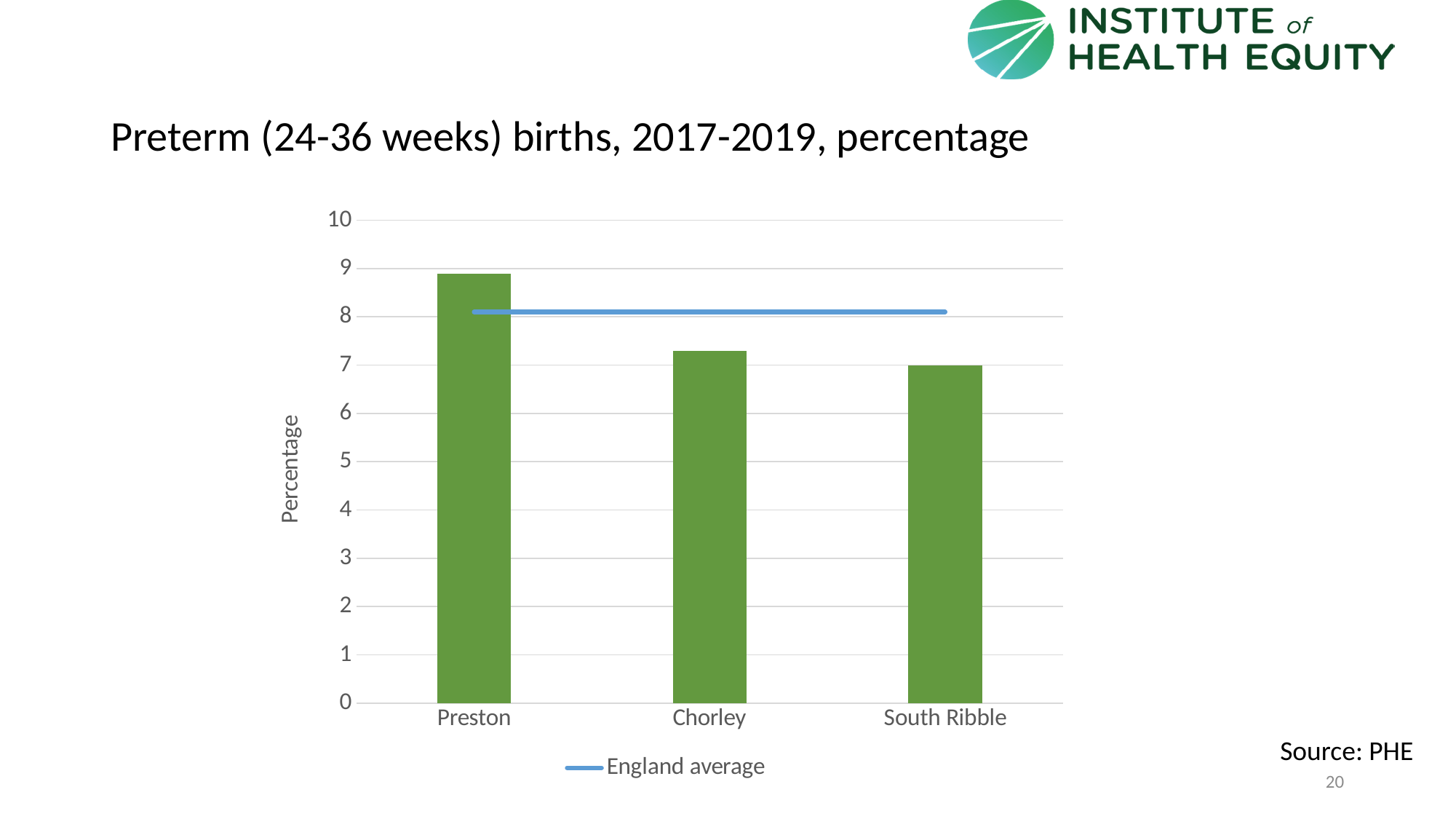
Do the bar values rise or fall from Preston to South Ribble along the x axis? fall What is the label on the y axis? Percentage Is the England average line above or below 9? below Which area has the lowest percentage of preterm births? South Ribble How many areas (bars) are plotted on the chart? 3 Is the value for Chorley greater or less than 8? less What does the blue horizontal line represent according to the legend? England average Is the value for South Ribble greater or less than 8? less What kind of chart is shown on the slide? bar chart Which has the larger value, Preston or Chorley? Preston Which area has the highest percentage of preterm births? Preston